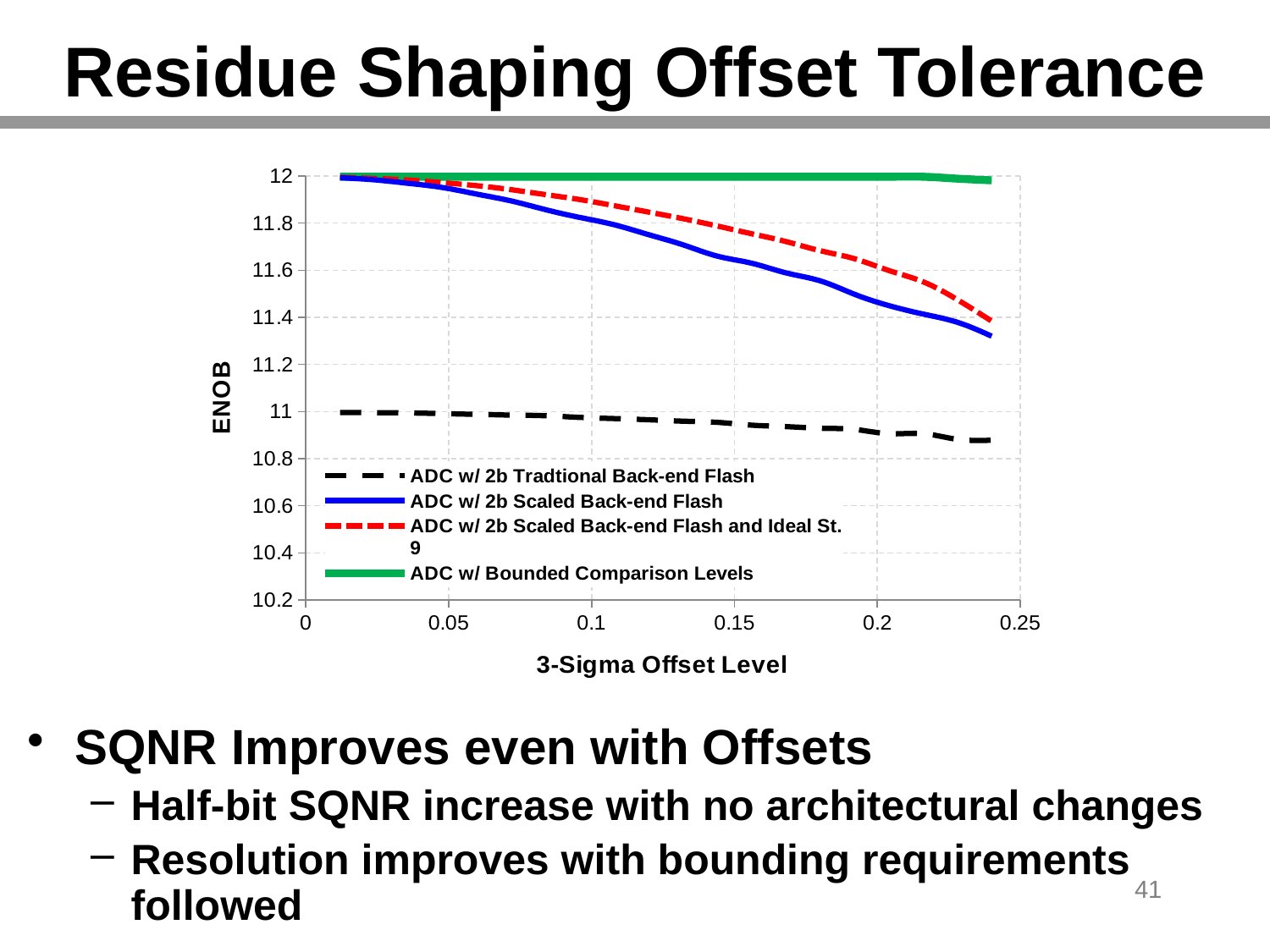
Does the ENOB for 'ADC w/ 2b Scaled Back-end Flash' rise or fall as the 3-Sigma Offset Level increases? fall Is the ENOB for 'ADC w/ Bounded Comparison Levels' at an offset level of 0.15 greater or less than 11.8? greater What kind of chart is shown on the slide? line chart What is the label of the y axis? ENOB How many series does the legend list? 4 At an offset level of 0.2, which has the higher ENOB: 'ADC w/ 2b Scaled Back-end Flash' or 'ADC w/ 2b Scaled Back-end Flash and Ideal St. 9'? ADC w/ 2b Scaled Back-end Flash and Ideal St. 9 Is the ENOB for 'ADC w/ 2b Scaled Back-end Flash' at an offset level of 0.1 greater or less than 11.6? greater Is the ENOB for 'ADC w/ 2b Tradtional Back-end Flash' at an offset level of 0.2 greater or less than 11? less Does the ENOB for 'ADC w/ Bounded Comparison Levels' stay roughly flat or fall sharply as the offset level increases? roughly flat What is the label of the x axis? 3-Sigma Offset Level Which series has the highest ENOB at a 3-Sigma Offset Level of 0.2? ADC w/ Bounded Comparison Levels Which series has the lowest ENOB across the whole range of offset levels? ADC w/ 2b Tradtional Back-end Flash